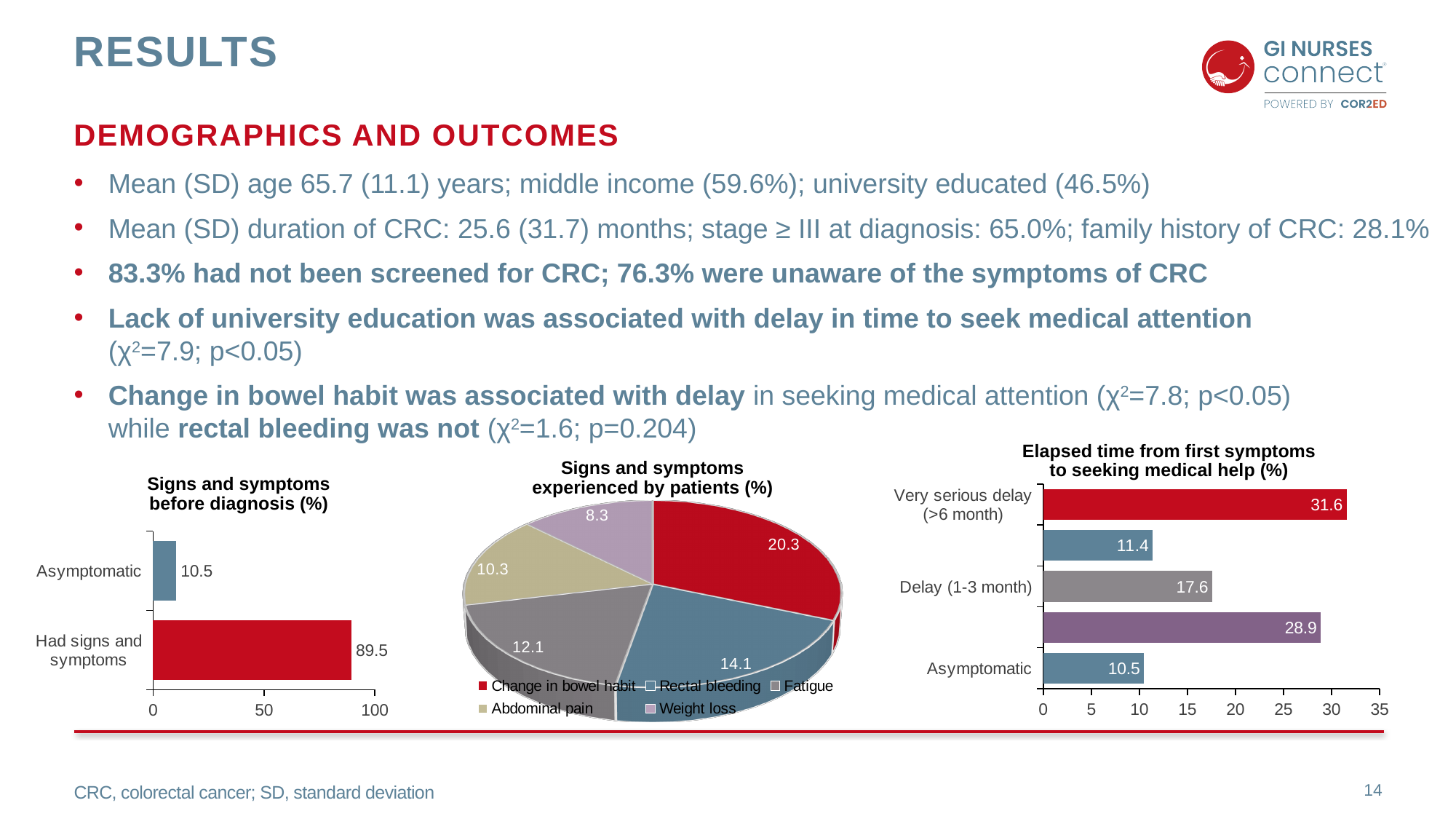
In the 'Signs and symptoms before diagnosis (%)' chart, what is the value for Had signs and symptoms? 89.5 What kind of chart is 'Signs and symptoms before diagnosis (%)'? Bar chart In the 'Signs and symptoms experienced by patients (%)' pie chart, which is larger, Rectal bleeding or Fatigue? Rectal bleeding In the 'Signs and symptoms experienced by patients (%)' pie chart, what is the value for Weight loss? 8.3 In the 'Signs and symptoms before diagnosis (%)' chart, what is the difference between Had signs and symptoms and Asymptomatic? 79 In the 'Elapsed time from first symptoms to seeking medical help (%)' chart, which category has the highest value? Very serious delay (>6 month) In the 'Elapsed time from first symptoms to seeking medical help (%)' chart, what is the value for Very serious delay (>6 month)? 31.6 In the 'Elapsed time from first symptoms to seeking medical help (%)' chart, what is the difference between Delay (1-3 month) and Asymptomatic? 7.1 In the 'Signs and symptoms experienced by patients (%)' pie chart, what is the value for Change in bowel habit? 20.3 How many categories does the legend of the 'Signs and symptoms experienced by patients (%)' pie chart list? 5 In the 'Signs and symptoms experienced by patients (%)' pie chart, which category has the largest slice? Change in bowel habit In the 'Signs and symptoms before diagnosis (%)' chart, what is the value for Asymptomatic? 10.5